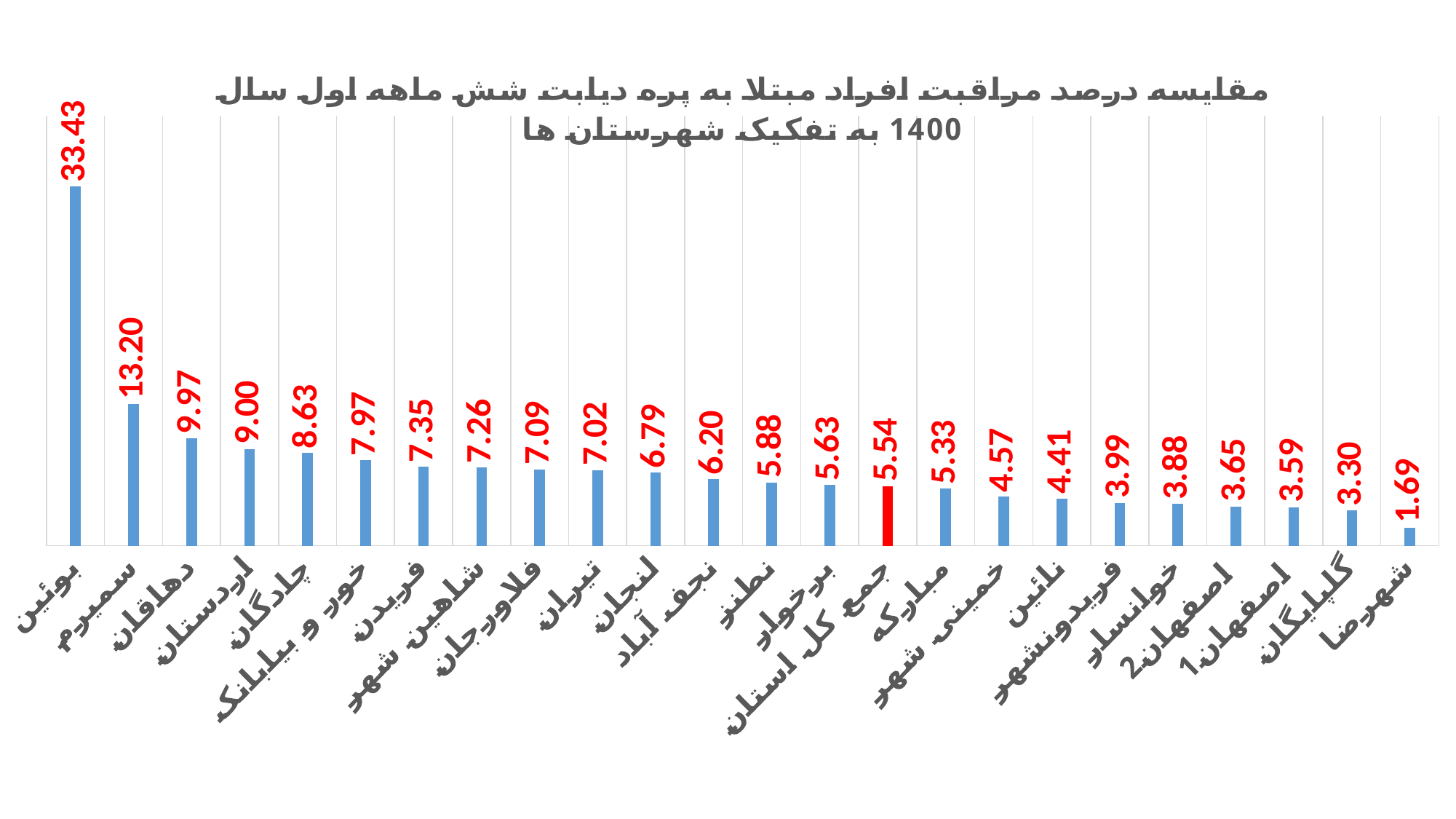
How many categories are shown in the chart? 24 What type of chart is shown on the slide? bar chart Which category has the lowest value? شهرضا What is the value for سمیرم? 13.20 Which is larger, the value for دهاقان or the value for اردستان? دهاقان What is the difference between the values for بوئین and سمیرم? 20.23 Which bar is coloured red instead of blue? جمع کل استان What is the value for جمع کل استان? 5.54 Do the values rise or fall from left to right along the x axis? fall What is the value for شهرضا? 1.69 What is the value for بوئین? 33.43 Which category has the highest value? بوئین